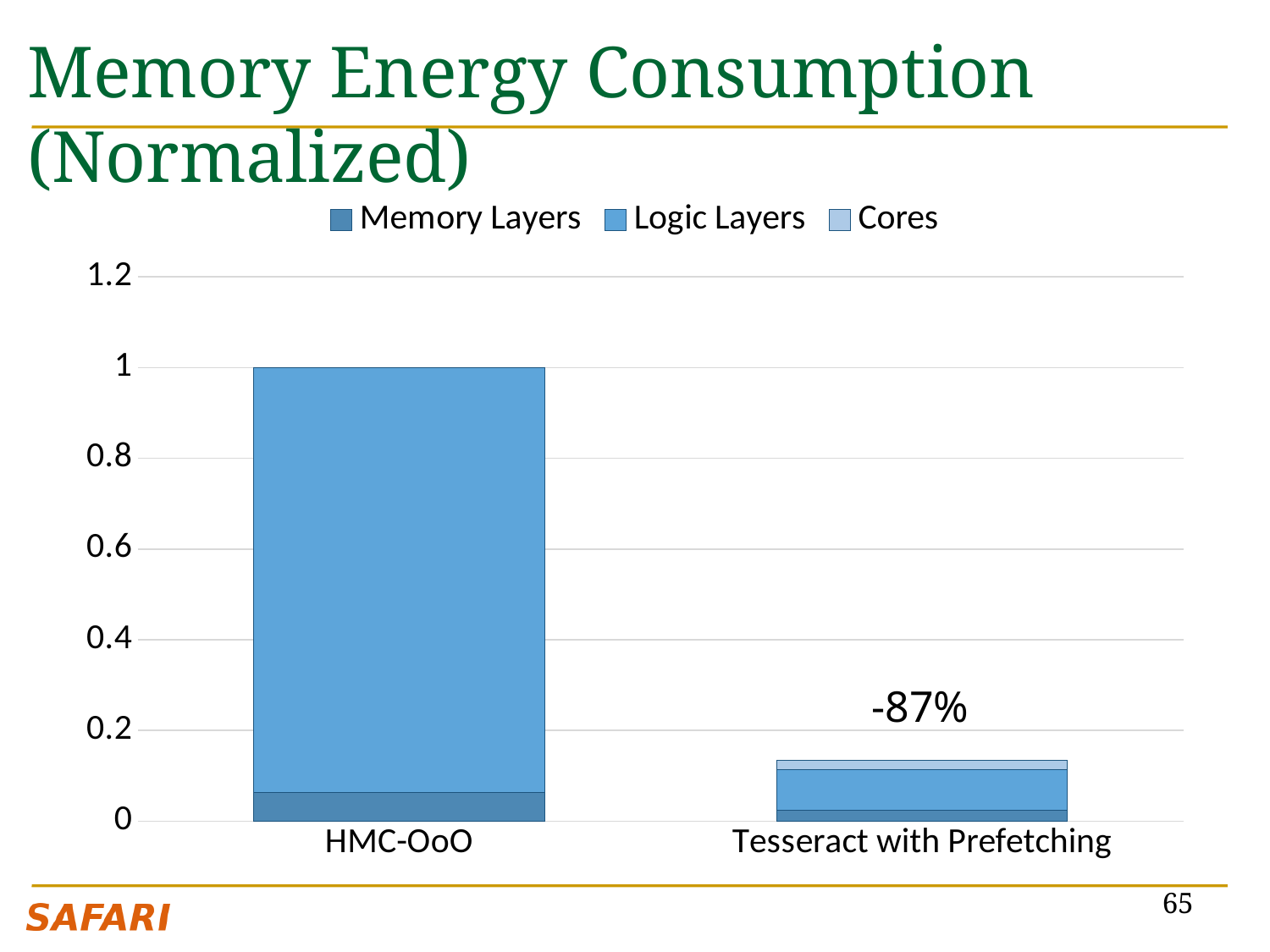
What is the total normalized memory energy consumption for HMC-OoO? 1 What is the title of the chart on the slide? Memory Energy Consumption (Normalized) How many categories are shown on the x axis of the chart? 2 Which category has the highest total memory energy consumption? HMC-OoO Is the total value for HMC-OoO greater or less than 0.8? greater Is the total value for Tesseract with Prefetching greater or less than 0.2? less Which category has the lowest total memory energy consumption? Tesseract with Prefetching What percentage change is labeled above the Tesseract with Prefetching bar? -87% Which has a larger total bar, HMC-OoO or Tesseract with Prefetching? HMC-OoO What are the three series listed in the chart's legend? Memory Layers, Logic Layers, Cores How many series does the chart's legend list? 3 What kind of chart is shown on the slide? bar chart